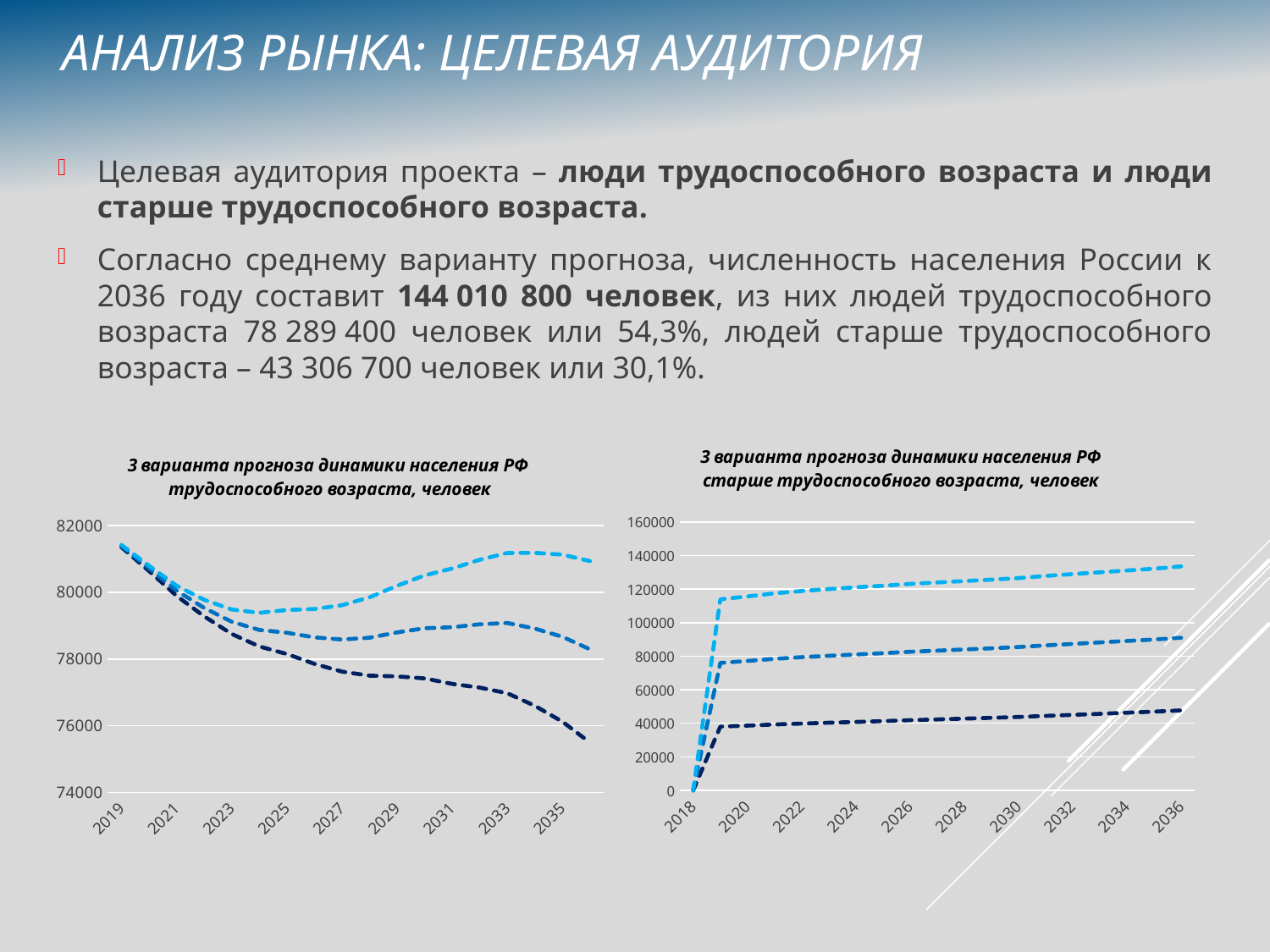
In the left chart (трудоспособного возраста), is the value of the highest (light blue) line in 2033 greater or less than 80000? greater In the right chart (старше трудоспособного возраста), how many forecast lines are plotted? 3 What is the highest value shown on the vertical axis of the right chart (старше трудоспособного возраста)? 160000 In the left chart (трудоспособного возраста), which line is higher in 2035: the light blue line or the dark blue line? the light blue line What kind of chart is the right chart titled '3 варианта прогноза динамики населения РФ старше трудоспособного возраста, человек'? line chart In the left chart (трудоспособного возраста), how many forecast lines are plotted? 3 What kind of chart is the left chart titled '3 варианта прогноза динамики населения РФ трудоспособного возраста, человек'? line chart In the left chart (трудоспособного возраста), does the dark blue (lowest) line rise or fall from 2019 to 2035? fall In the right chart (старше трудоспособного возраста), is the value of the topmost line in 2036 greater or less than 120000? greater In the left chart (трудоспособного возраста), is the value of the lowest (dark blue) line in 2031 greater or less than 76000? greater In the right chart (старше трудоспособного возраста), do the three lines rise or fall between 2020 and 2036? rise